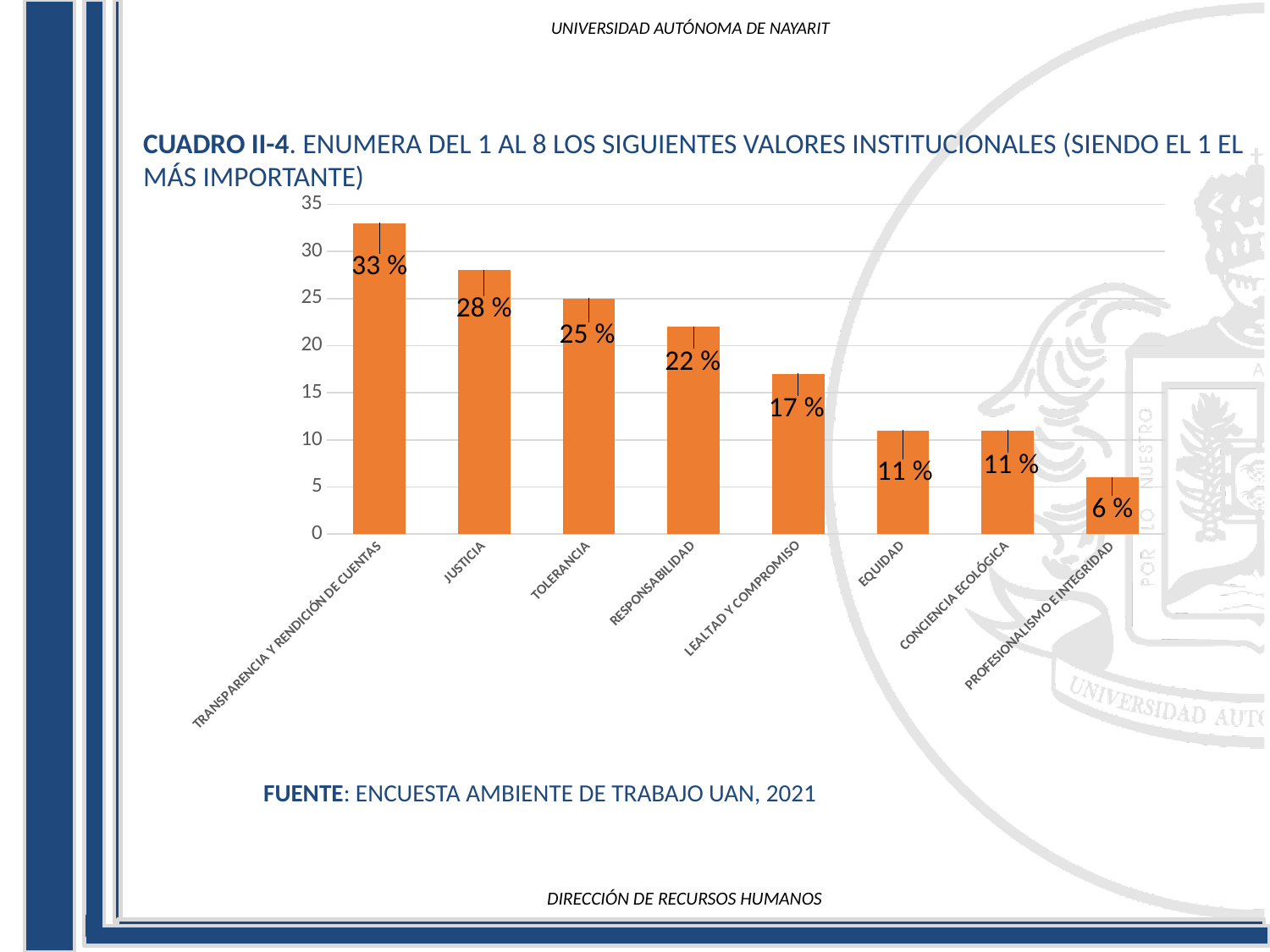
Which category has the highest value? TRANSPARENCIA Y RENDICIÓN DE CUENTAS What kind of chart is shown on the slide? bar chart Which is larger, the value for JUSTICIA or the value for TOLERANCIA? JUSTICIA What is the value for PROFESIONALISMO E INTEGRIDAD? 6 % What is the difference between the values for TOLERANCIA and RESPONSABILIDAD? 3 % Which category has the lowest value? PROFESIONALISMO E INTEGRIDAD What is the value for LEALTAD Y COMPROMISO? 17 % Is the value for RESPONSABILIDAD greater or less than 20? greater What is the value for JUSTICIA? 28 % Do the values rise or fall from left to right along the x axis? fall How many categories are shown on the x axis? 8 What is the difference between the values for TRANSPARENCIA Y RENDICIÓN DE CUENTAS and EQUIDAD? 22 %